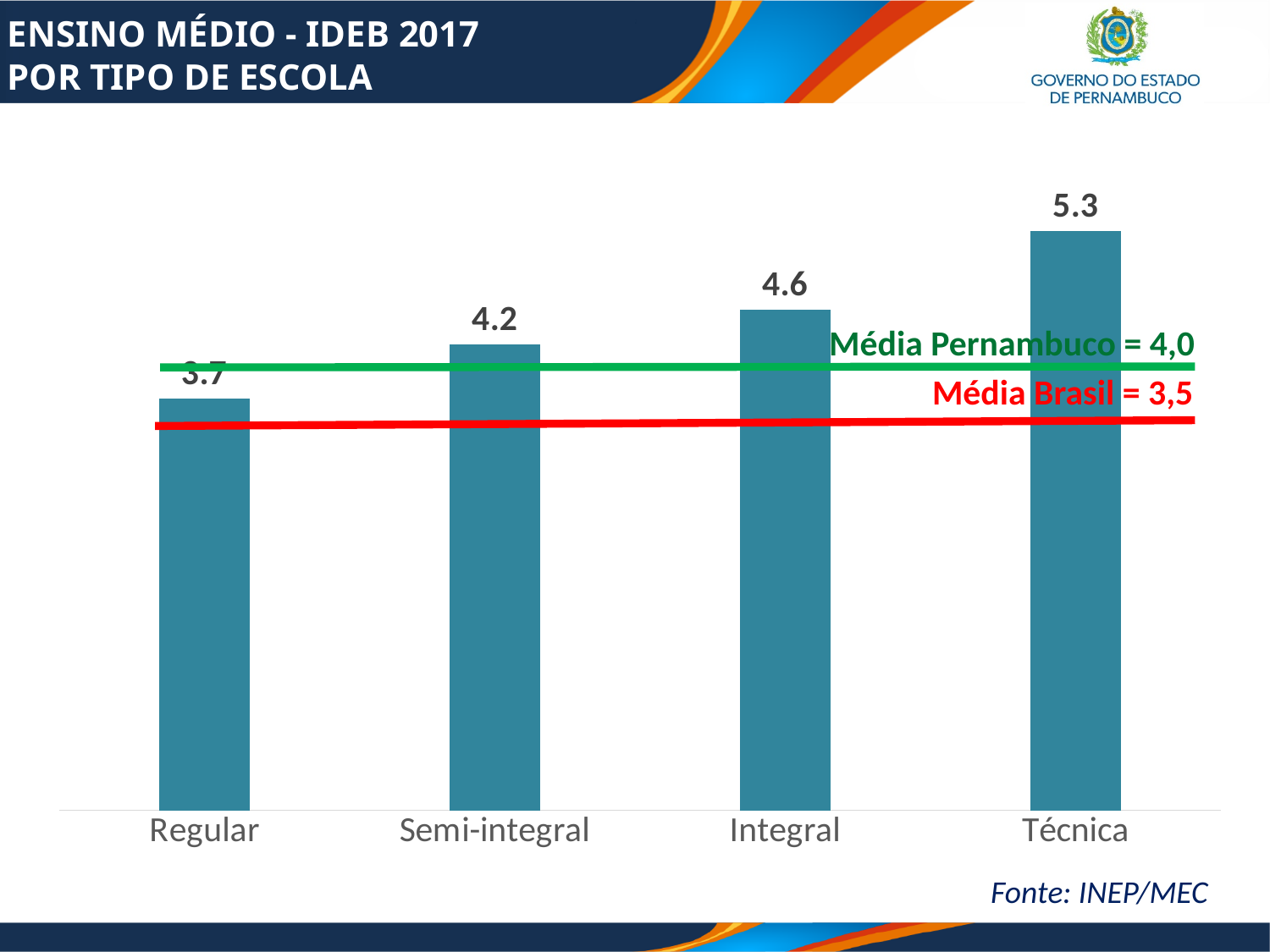
What is the IDEB 2017 value for Técnica schools? 5.3 Which type of school has the lowest IDEB 2017 value? Regular What value does the green reference line labelled Média Pernambuco represent? 4,0 What is the difference between the values for Técnica and Integral schools? 0.7 Do the values rise or fall from Regular to Técnica along the x axis? Rise What is the IDEB 2017 value for Semi-integral schools? 4.2 How many types of school are shown in the chart? 4 What is the IDEB 2017 value for Integral schools? 4.6 Which type of school has the highest IDEB 2017 value? Técnica What is the difference between the values for Técnica and Semi-integral schools? 1.1 Which has a higher IDEB value, Semi-integral or Integral? Integral What kind of chart is shown on the slide? Bar chart